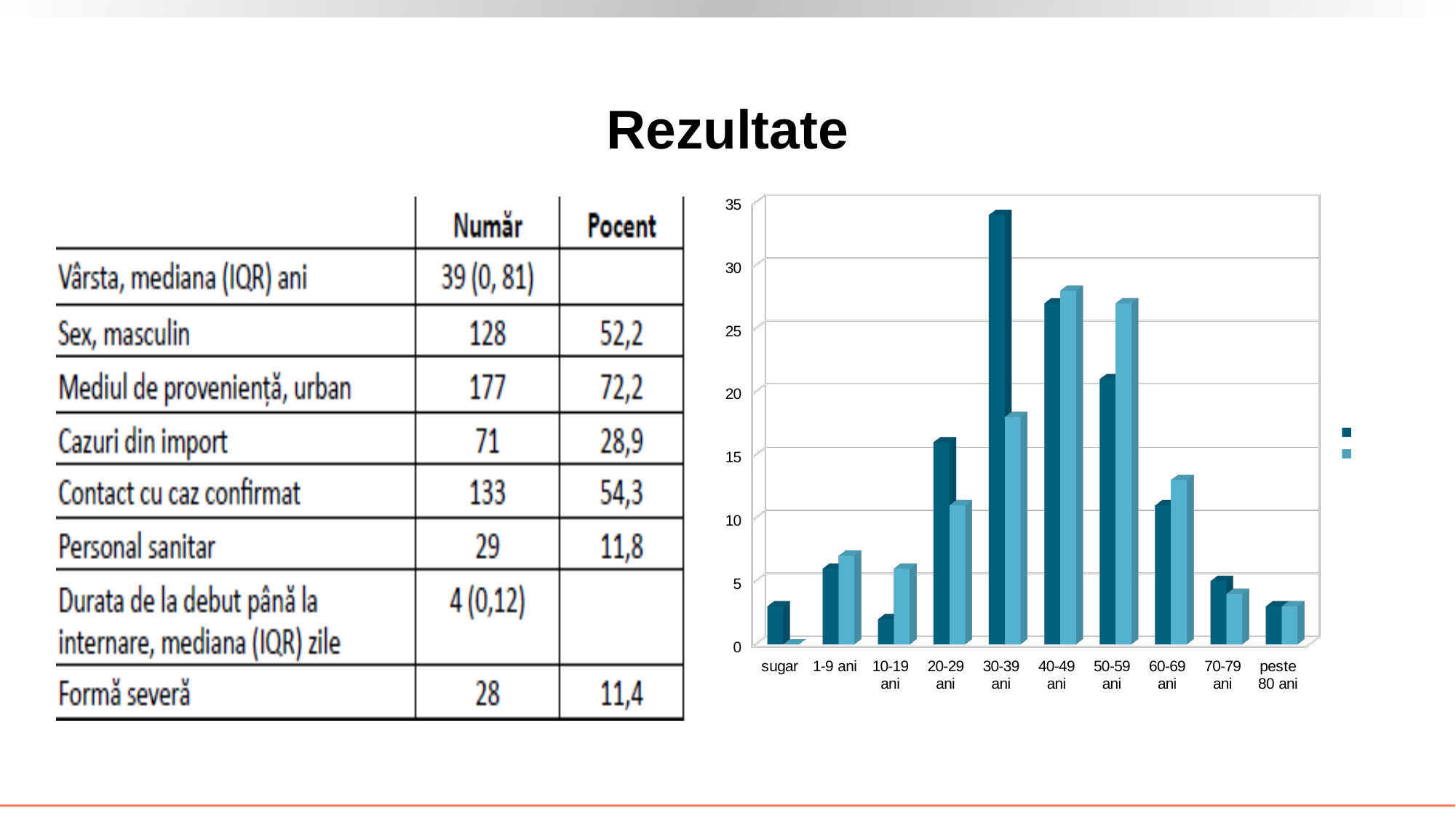
In the bar chart, is the light blue value for 60-69 ani greater or less than 10? greater How many age categories are shown on the x axis of the bar chart? 10 In the bar chart, is the dark blue value for 30-39 ani greater or less than 30? greater How many series does the legend of the bar chart list? 2 In the bar chart, which age category has the highest value for the dark blue series? 30-39 ani What kind of chart is shown on the right of the slide? bar chart What is the label of the last category on the x axis of the bar chart? peste 80 ani In the bar chart, for 30-39 ani, which series has the larger value, the dark blue or the light blue? dark blue In the bar chart, for 60-69 ani, which series has the larger value, the dark blue or the light blue? light blue In the bar chart, is the light blue value for 30-39 ani greater or less than 20? less In the bar chart, which age category has the lowest value for the light blue series? sugar